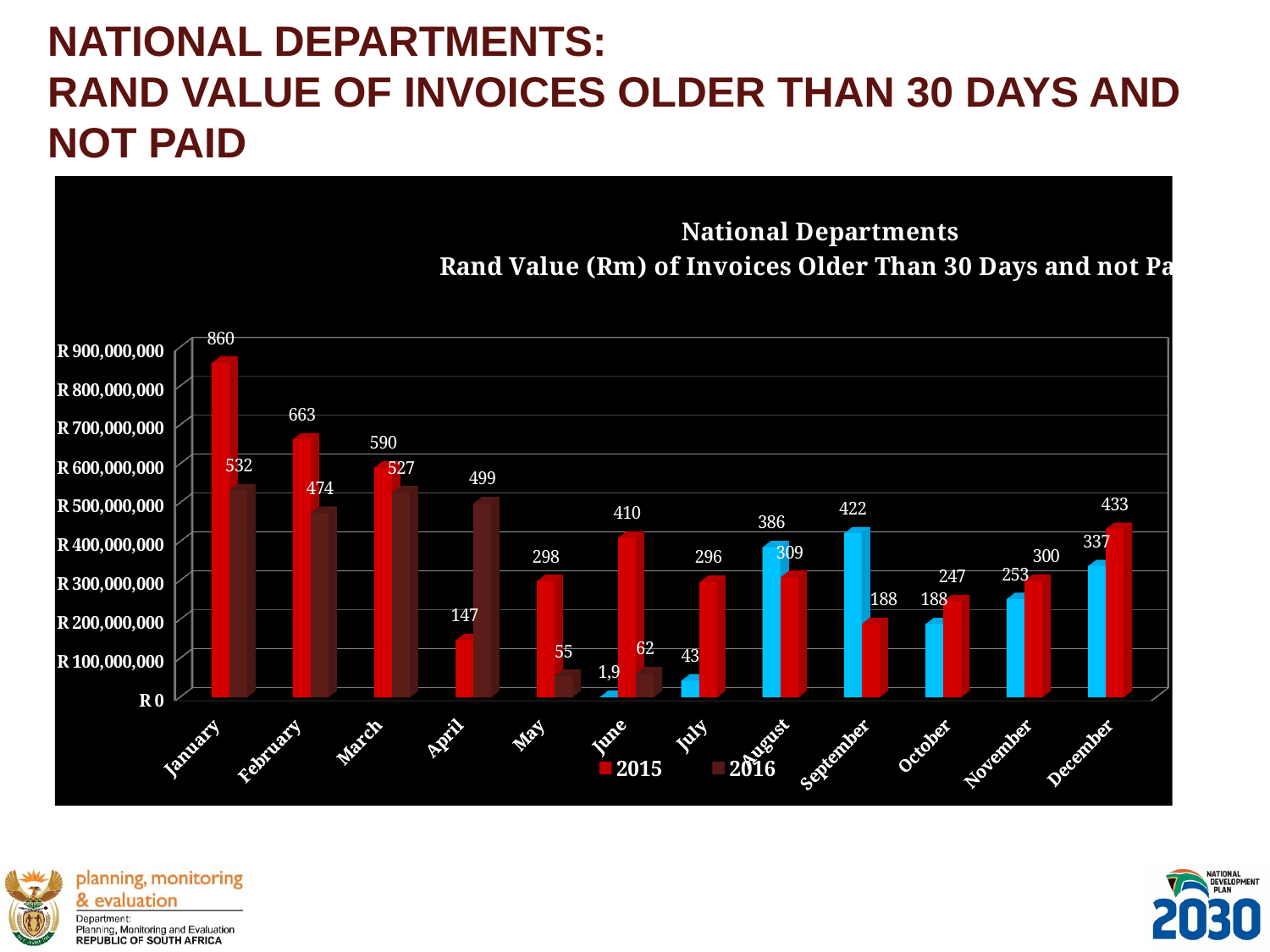
What kind of chart is shown on the slide? Bar chart Which month has the highest value on the chart? January For April, which series has the larger value, 2015 or 2016? 2016 What is the 2016 value for April? 499 How many months are shown on the x axis? 12 How many series does the legend list? 2 What is the difference between the 2015 and 2016 values for January? 328 What is the difference between the 2015 and 2016 values for March? 63 What is the 2015 value for January? 860 What is the 2016 value for May? 55 From January to April, do the 2015 values rise or fall? Fall Among January to May, which month has the lowest 2016 value? May